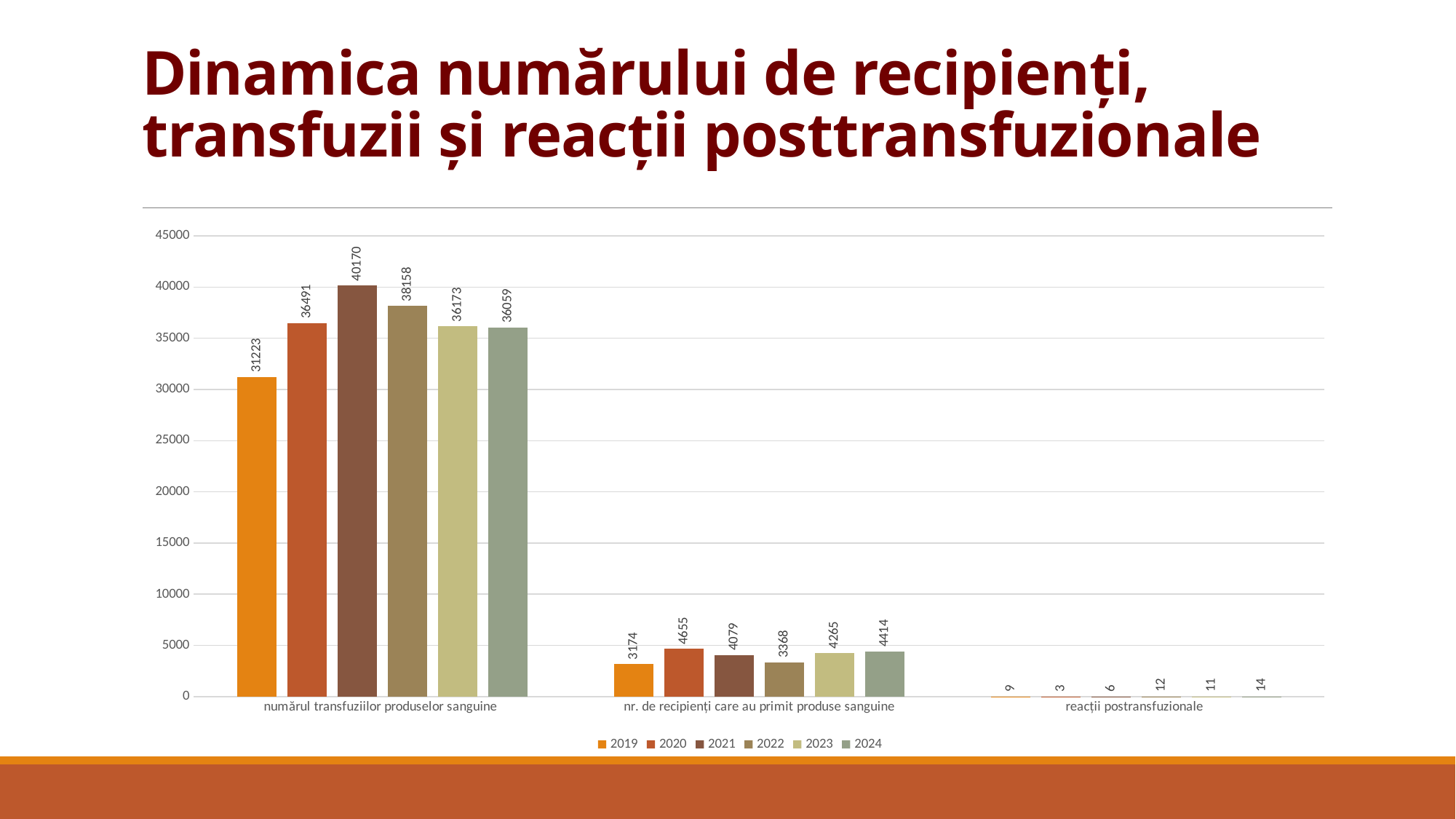
Is the value for 2022 in the category 'numărul transfuziilor produselor sanguine' greater or less than 35000? greater What kind of chart is shown on the slide? bar chart What is the value for 2021 in the category 'numărul transfuziilor produselor sanguine'? 40170 Which year has the highest value in the category 'numărul transfuziilor produselor sanguine'? 2021 In the category 'nr. de recipienți care au primit produse sanguine', which is larger, the value for 2020 or the value for 2023? 2020 Which year has the lowest value in the category 'reacții postransfuzionale'? 2020 How many series does the legend list? 6 What is the value for 2024 in the category 'reacții postransfuzionale'? 14 What is the difference between the 2021 and 2019 values in the category 'numărul transfuziilor produselor sanguine'? 8947 What is the value for 2019 in the category 'nr. de recipienți care au primit produse sanguine'? 3174 Which year is shown in orange in the legend? 2019 How many categories are shown on the x axis? 3